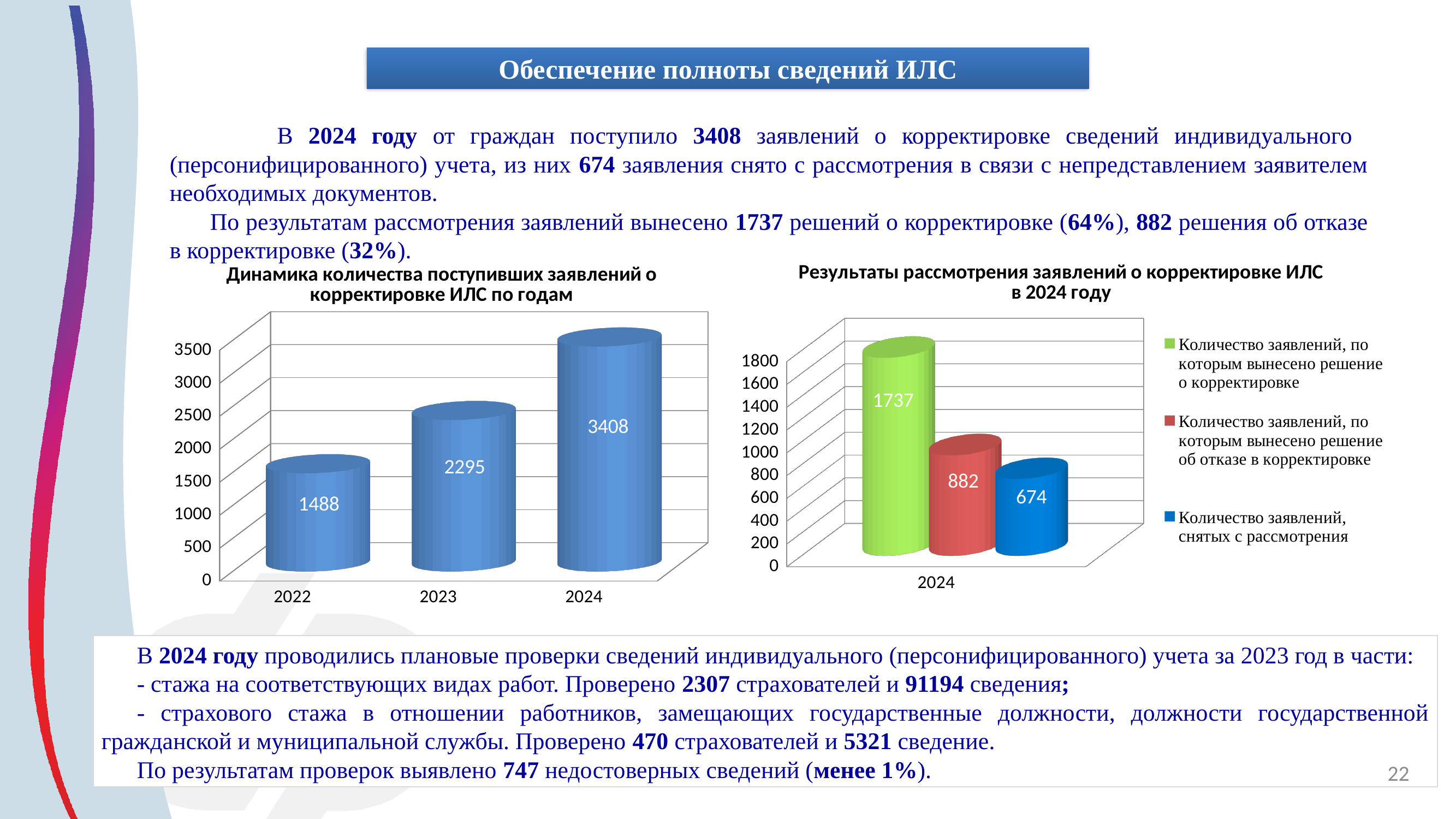
In the left chart 'Динамика количества поступивших заявлений о корректировке ИЛС по годам', what is the value for 2023? 2295 In the left chart 'Динамика количества поступивших заявлений о корректировке ИЛС по годам', what is the difference between the values for 2024 and 2022? 1920 In the right chart 'Результаты рассмотрения заявлений о корректировке ИЛС в 2024 году', what is the difference between the values 1737 and 882? 855 In the right chart 'Результаты рассмотрения заявлений о корректировке ИЛС в 2024 году', which is larger: the value for decisions on correction (green) or the value for applications withdrawn from consideration (blue)? Количество заявлений, по которым вынесено решение о корректировке In the left chart 'Динамика количества поступивших заявлений о корректировке ИЛС по годам', do the values rise or fall from 2022 to 2024? rise In the left chart 'Динамика количества поступивших заявлений о корректировке ИЛС по годам', what is the value for 2022? 1488 What kind of chart is the left chart 'Динамика количества поступивших заявлений о корректировке ИЛС по годам'? bar chart In the right chart 'Результаты рассмотрения заявлений о корректировке ИЛС в 2024 году', how many series does the legend list? 3 In the left chart 'Динамика количества поступивших заявлений о корректировке ИЛС по годам', how many years are shown on the x axis? 3 In the left chart 'Динамика количества поступивших заявлений о корректировке ИЛС по годам', which year has the highest value? 2024 In the right chart 'Результаты рассмотрения заявлений о корректировке ИЛС в 2024 году', which series has the lowest value? Количество заявлений, снятых с рассмотрения In the right chart 'Результаты рассмотрения заявлений о корректировке ИЛС в 2024 году', what is the value for 'Количество заявлений, по которым вынесено решение об отказе в корректировке'? 882